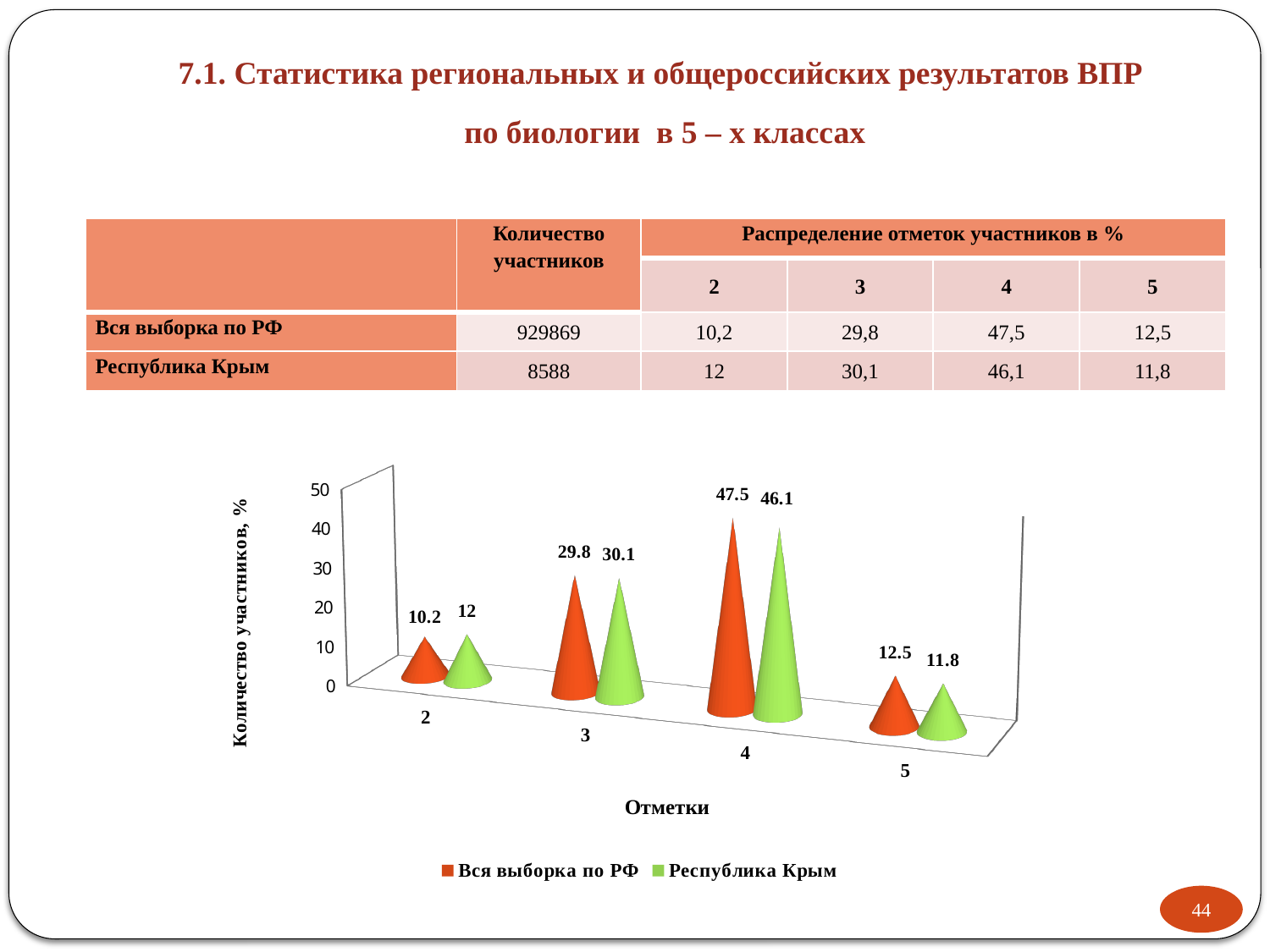
What kind of chart is shown on the slide? Bar chart (3D cone bars) What is the value for Республика Крым at mark 2? 12 Which mark has the highest value for Республика Крым? 4 What is the value for Вся выборка по РФ at mark 4? 47.5 Which mark has the lowest value for Вся выборка по РФ? 2 At mark 2, which series has the larger value: Вся выборка по РФ or Республика Крым? Республика Крым What is the difference between Вся выборка по РФ and Республика Крым at mark 4? 1.4 What is the label of the x axis? Отметки What is the value for Вся выборка по РФ at mark 5? 12.5 How many series does the legend list? 2 What is the value for Республика Крым at mark 3? 30.1 How many marks (categories) are shown on the x axis? 4